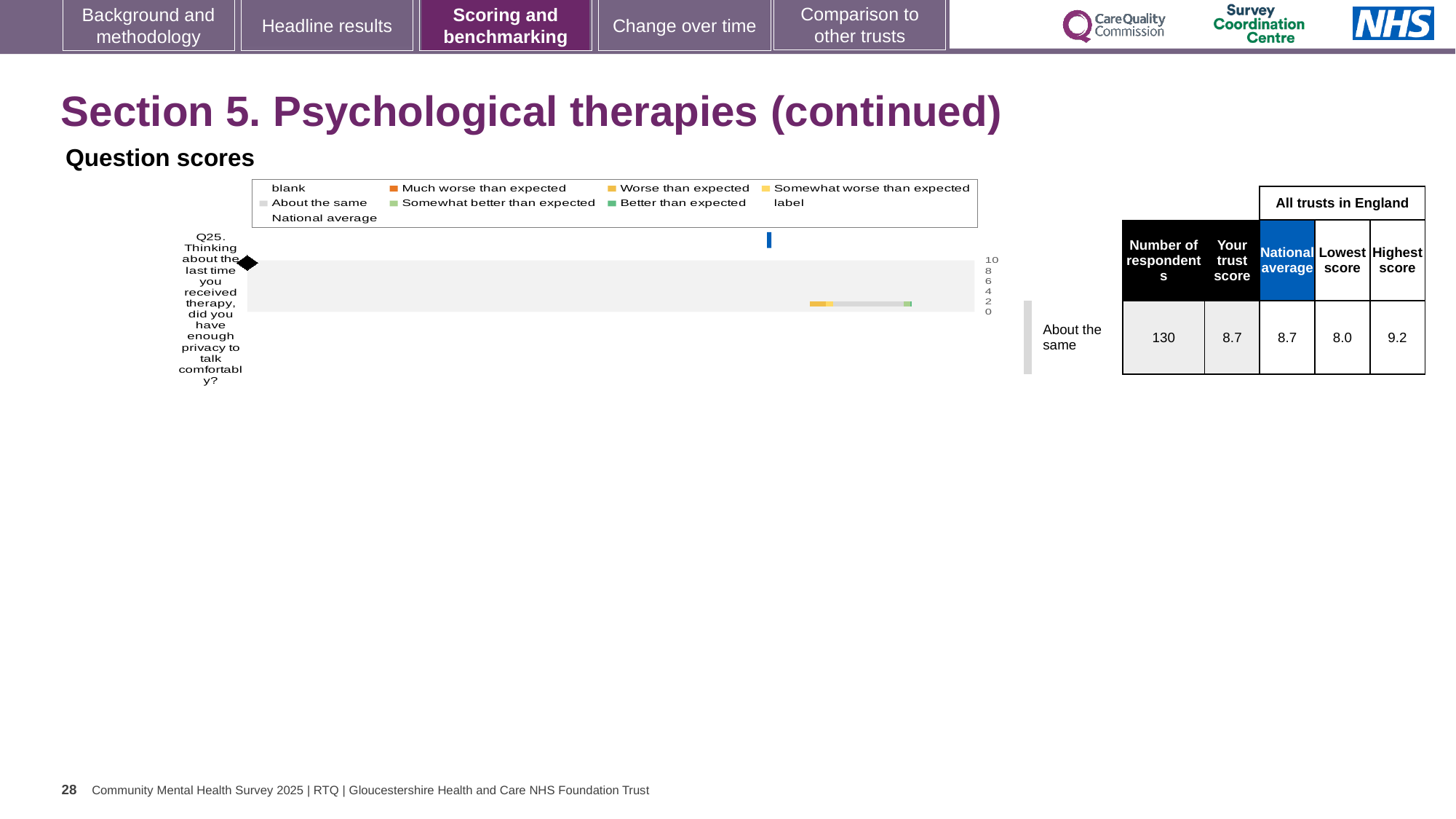
What colour is the legend marker for 'Much worse than expected' in the question scores chart? orange What is the highest tick value shown on the axis of the question scores chart? 10 In the table beside the chart, what is the trust score for Q25? 8.7 Which question number is plotted in the question scores chart? Q25 In the table beside the chart, how many respondents answered Q25? 130 What benchmark category label is shown next to the Q25 bar? About the same In the table beside the chart, which is larger for Q25: the highest score or the lowest score? Highest score How many questions (categories) are plotted in the question scores chart? 1 In the table beside the chart, what is the national average for Q25? 8.7 How many entries does the legend of the question scores chart list? 9 In the table beside the chart, what is the difference between the highest score and the lowest score for Q25? 1.2 What kind of chart is shown under 'Question scores'? bar chart